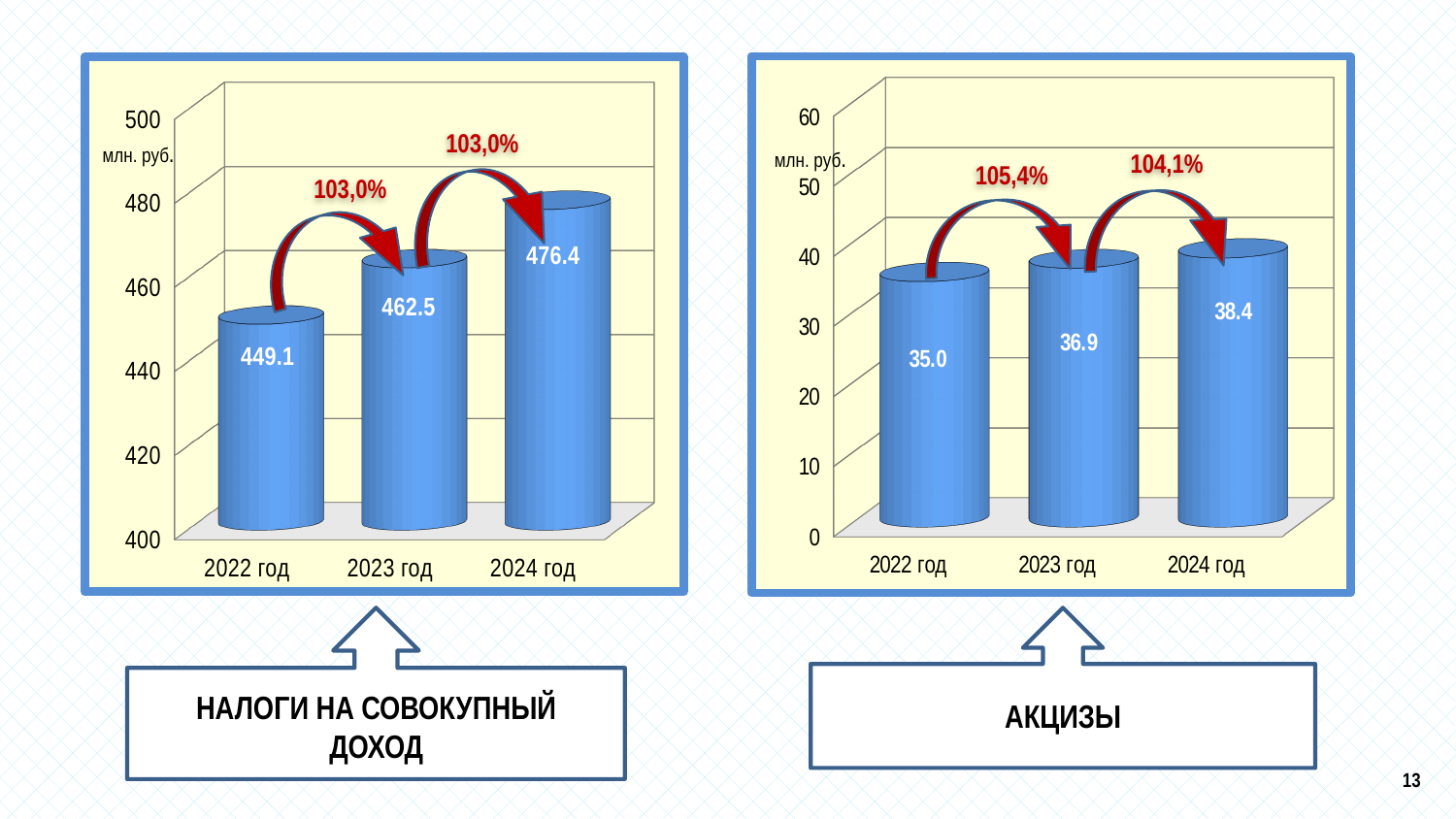
In the right chart (АКЦИЗЫ), what is the value for 2024 год? 38.4 What kind of chart is the left chart (НАЛОГИ НА СОВОКУПНЫЙ ДОХОД)? bar chart In the left chart (НАЛОГИ НА СОВОКУПНЫЙ ДОХОД), which year has the highest value? 2024 год In the right chart (АКЦИЗЫ), which is larger: the value for 2022 год or 2024 год? 2024 год In the left chart (НАЛОГИ НА СОВОКУПНЫЙ ДОХОД), what is the value for 2022 год? 449.1 In the left chart (НАЛОГИ НА СОВОКУПНЫЙ ДОХОД), what is the value for 2024 год? 476.4 In the right chart (АКЦИЗЫ), what is the difference between the values for 2023 год and 2022 год? 1.9 How many years are shown in the left chart (НАЛОГИ НА СОВОКУПНЫЙ ДОХОД)? 3 Do the values in the right chart (АКЦИЗЫ) rise or fall from 2022 год to 2024 год? rise In the left chart (НАЛОГИ НА СОВОКУПНЫЙ ДОХОД), what is the difference between the values for 2024 год and 2023 год? 13.9 In the right chart (АКЦИЗЫ), what is the value for 2023 год? 36.9 In the right chart (АКЦИЗЫ), which year has the lowest value? 2022 год